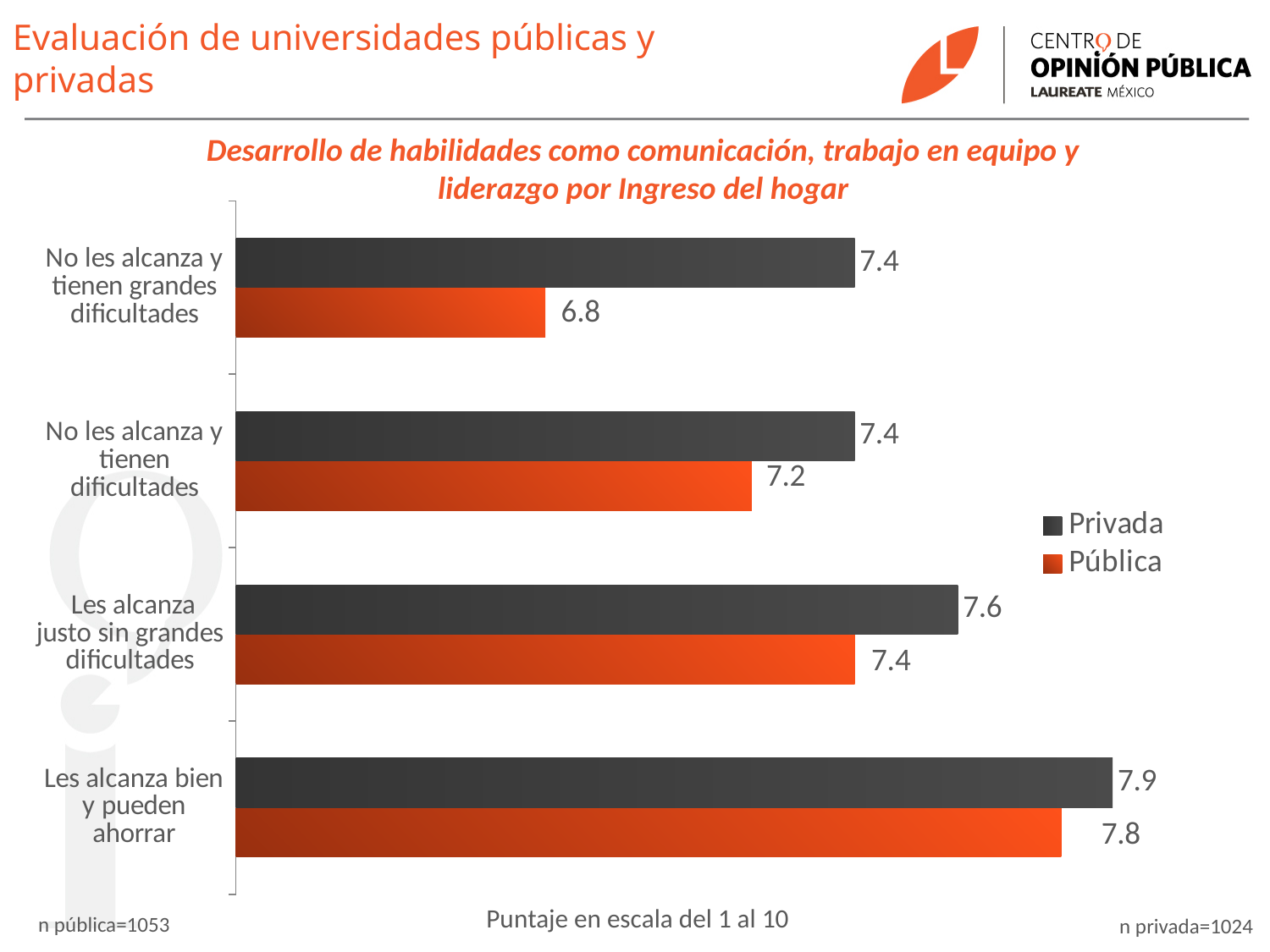
What is the Privada value for 'Les alcanza justo sin grandes dificultades'? 7.6 Which is larger for 'No les alcanza y tienen dificultades': the Privada value or the Pública value? Privada How many series does the legend list? 2 How many income categories are shown on the chart? 4 What is the Pública value for 'Les alcanza bien y pueden ahorrar'? 7.8 Which colour represents the Pública series in the legend? Orange Which category has the lowest Pública value? No les alcanza y tienen grandes dificultades Which category has the highest Privada value? Les alcanza bien y pueden ahorrar What is the difference between the Privada and Pública values for 'No les alcanza y tienen grandes dificultades'? 0.6 What is the Pública value for 'No les alcanza y tienen grandes dificultades'? 6.8 What kind of chart is shown on the slide? Bar chart What is the Privada value for 'No les alcanza y tienen grandes dificultades'? 7.4